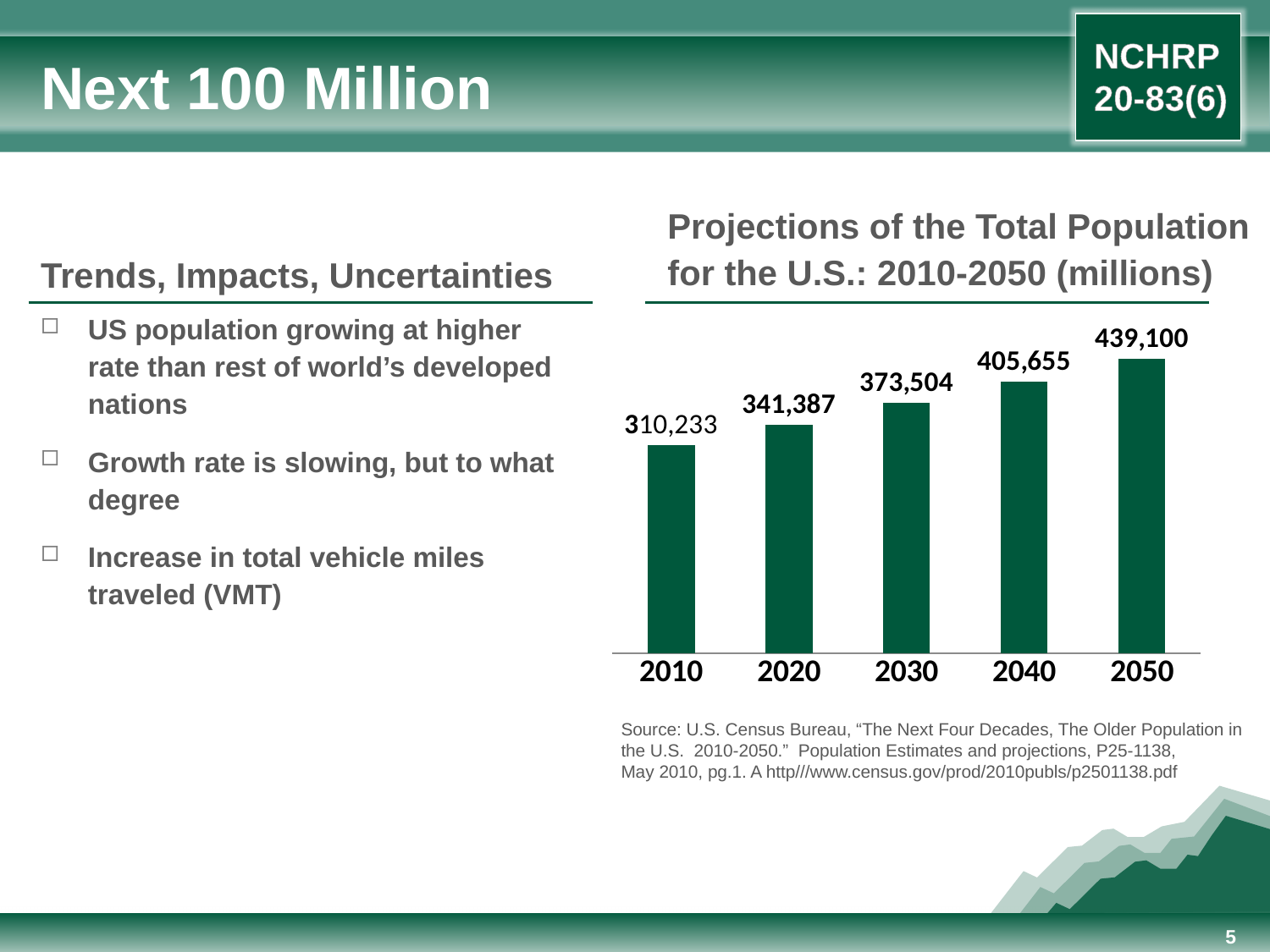
What is the projected U.S. population value shown for 2050? 439,100 What kind of chart is used to show the population projections? Bar chart How many years are shown on the x axis of the chart? 5 What is the title of the chart on the slide? Projections of the Total Population for the U.S.: 2010-2050 (millions) Which year has the lowest projected population in the chart? 2010 Do the projected population values rise or fall from 2010 to 2050? Rise What is the difference between the projected population values for 2040 and 2030? 32,151 What is the projected U.S. population value shown for 2010? 310,233 What is the difference between the projected population values for 2050 and 2010? 128,867 Which year has a larger projected population, 2020 or 2040? 2040 Which year has the highest projected population in the chart? 2050 What is the projected U.S. population value shown for 2030? 373,504